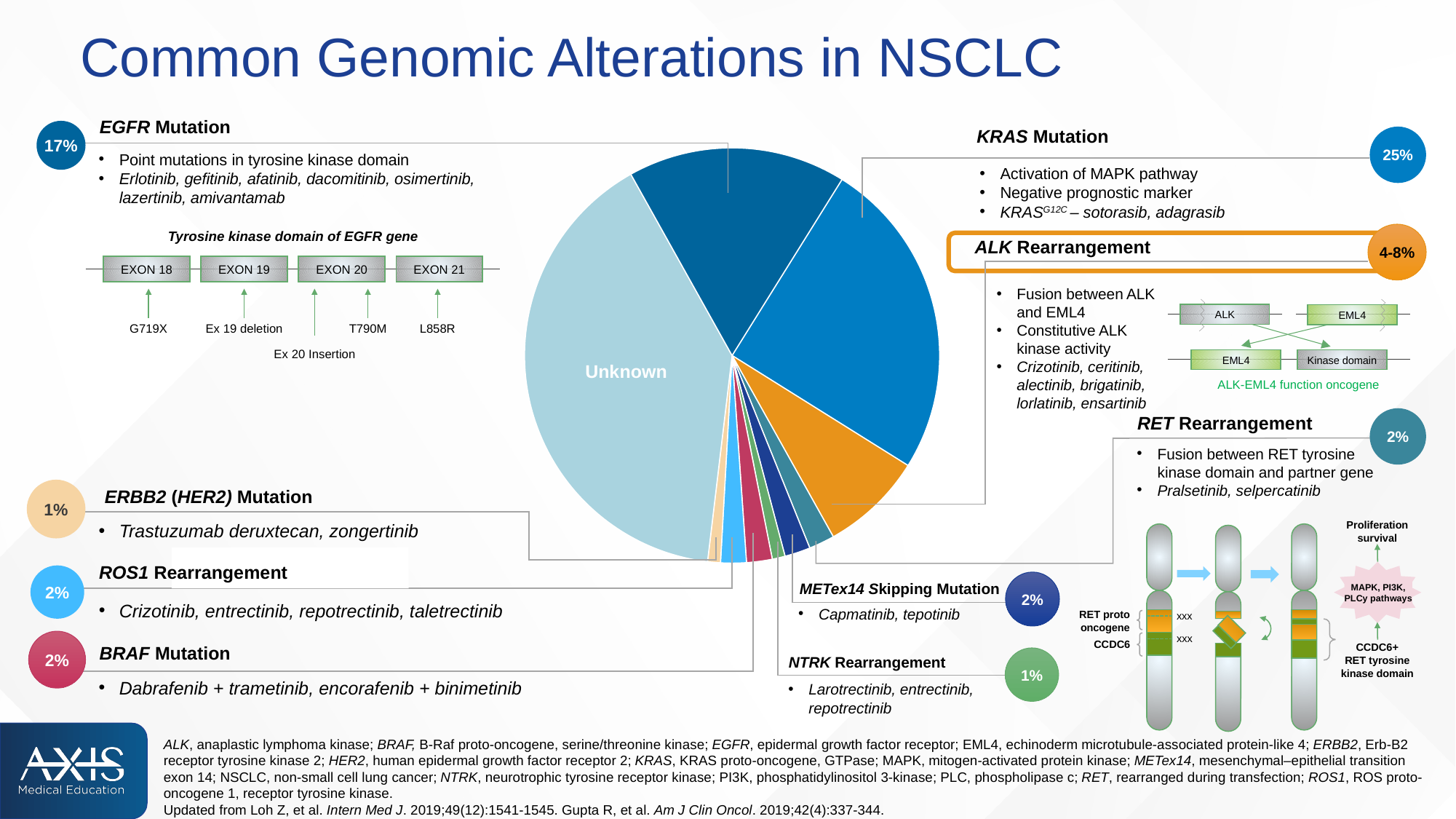
Which slice of the pie chart is labeled directly on the chart? Unknown What percentage is shown for KRAS Mutation? 25% What percentage is shown for METex14 Skipping Mutation? 2% Which is larger, the percentage for KRAS Mutation or for EGFR Mutation? KRAS Mutation What is the difference between the percentages for KRAS Mutation and EGFR Mutation? 8% Which slice is the largest in the pie chart? Unknown What percentage is shown for NTRK Rearrangement? 1% What percentage is shown for ERBB2 (HER2) Mutation? 1% What percentage is shown for EGFR Mutation? 17% What percentage range is shown for ALK Rearrangement? 4-8% Among the named genomic alterations, which has the highest percentage? KRAS Mutation What kind of chart is shown on the slide? pie chart